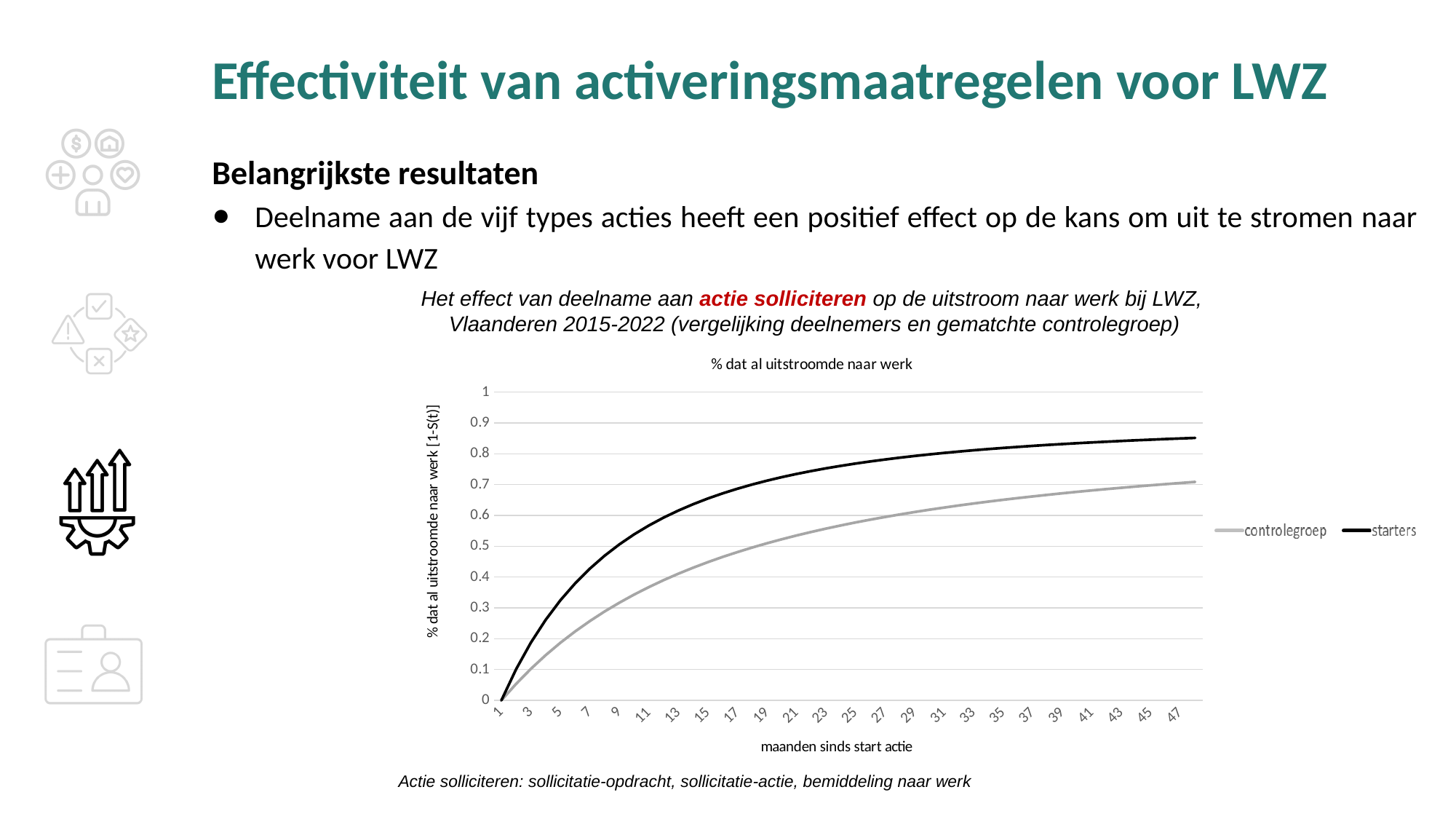
Do the values for the starters series rise or fall as the months since the start of the action increase? rise Is the value for starters at month 47 greater or less than 0.8? greater At month 13, which series has the lower value, starters or controlegroep? controlegroep Which two series are listed in the legend? controlegroep and starters How many series does the legend list? 2 What is the label of the x axis? maanden sinds start actie Is the value for controlegroep at month 47 greater or less than 0.8? less What kind of chart is shown on the slide? line chart Do the values for the controlegroep series rise or fall along the x axis? rise Is the value for starters at month 13 greater or less than 0.5? greater At month 47, which series has the higher value, starters or controlegroep? starters